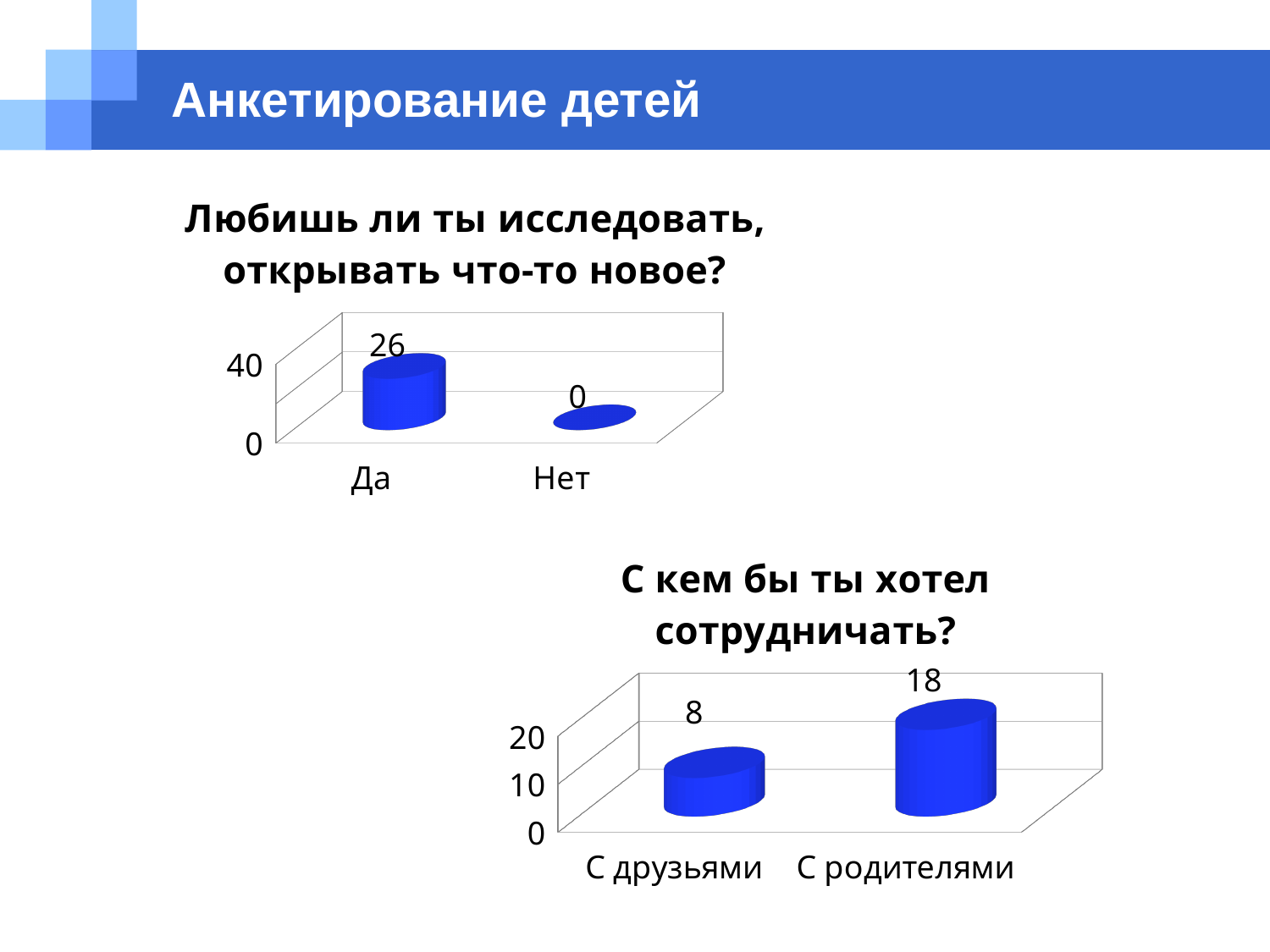
In the chart titled "Любишь ли ты исследовать, открывать что-то новое?", what is the value for "Нет"? 0 What kind of chart is the chart titled "С кем бы ты хотел сотрудничать?"? bar chart In the chart titled "Любишь ли ты исследовать, открывать что-то новое?", how many categories are shown? 2 In the chart titled "С кем бы ты хотел сотрудничать?", is the value for "С друзьями" greater or less than 10? less In the chart titled "С кем бы ты хотел сотрудничать?", what is the value for "С друзьями"? 8 In the chart titled "Любишь ли ты исследовать, открывать что-то новое?", what is the difference between the values for "Да" and "Нет"? 26 In the chart titled "С кем бы ты хотел сотрудничать?", which category has the lowest value? С друзьями In the chart titled "С кем бы ты хотел сотрудничать?", what is the difference between the values for "С родителями" and "С друзьями"? 10 In the chart titled "С кем бы ты хотел сотрудничать?", what is the value for "С родителями"? 18 In the chart titled "С кем бы ты хотел сотрудничать?", which is larger: the value for "С друзьями" or "С родителями"? С родителями In the chart titled "Любишь ли ты исследовать, открывать что-то новое?", which category has the highest value? Да In the chart titled "Любишь ли ты исследовать, открывать что-то новое?", what is the value for "Да"? 26